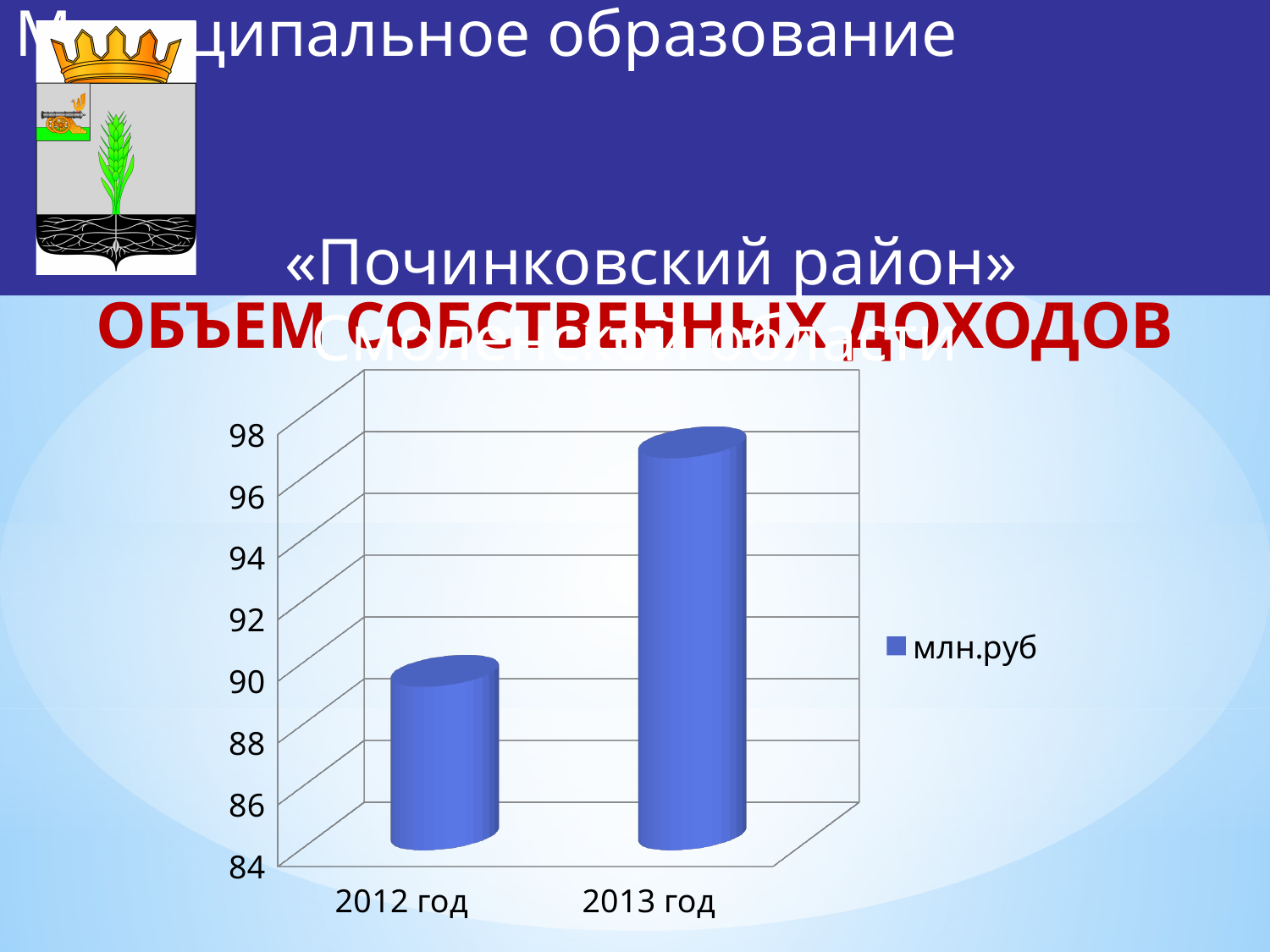
Do the values rise or fall from 2012 год to 2013 год? rise Is the value for 2012 год greater or less than 88? greater How many series does the chart legend list? 1 Which year has the highest value in the chart? 2013 год Which year has the lowest value in the chart? 2012 год Is the value for 2012 год greater or less than 92? less How many categories are shown on the x axis of the chart? 2 Which is larger, the value for 2012 год or the value for 2013 год? 2013 год What is the legend entry of the chart? млн.руб What is the title of the chart? ОБЪЕМ СОБСТВЕННЫХ ДОХОДОВ Is the value for 2013 год greater or less than 94? greater What type of chart is shown on the slide? bar chart